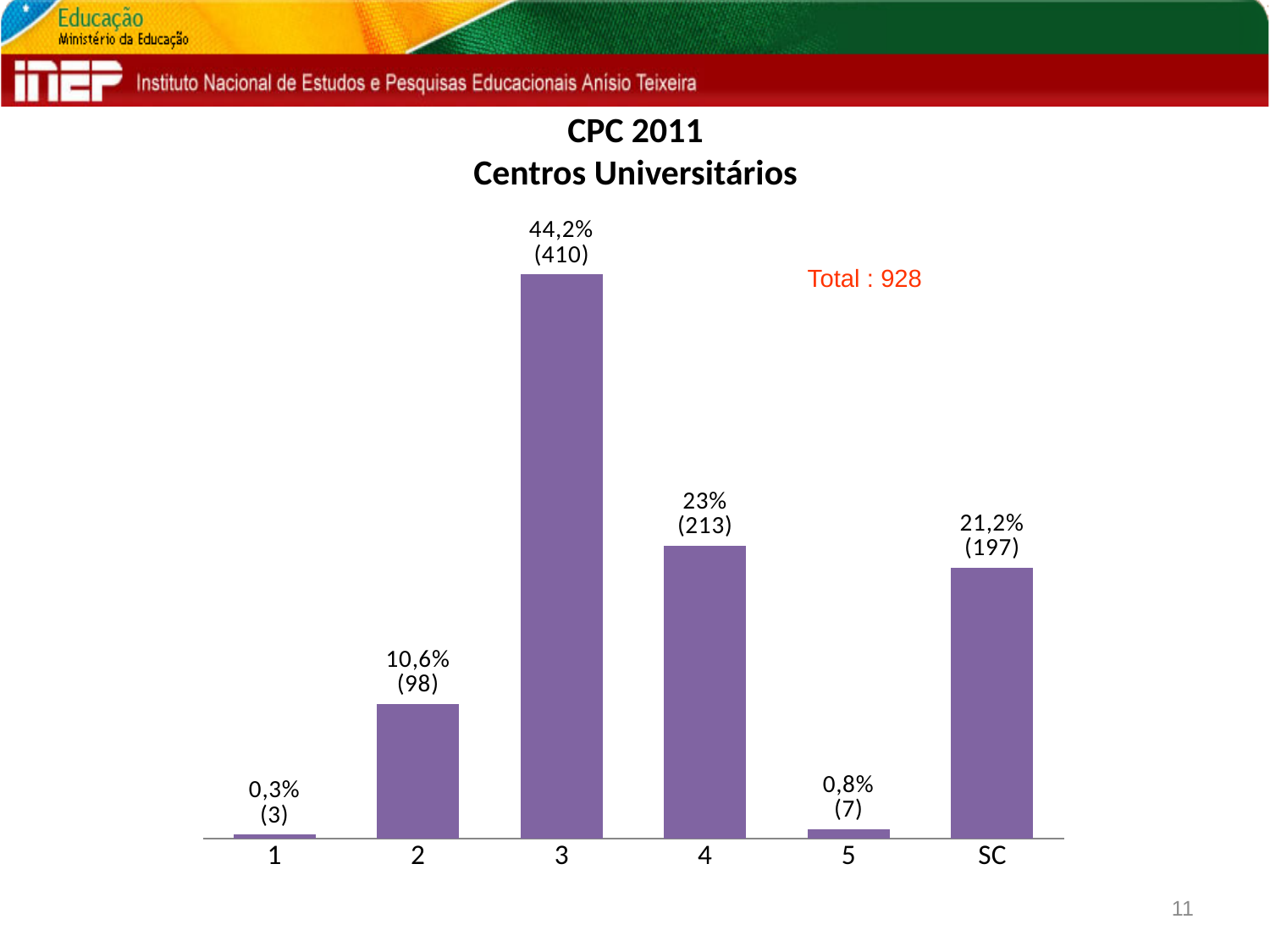
Which category has the highest value? 3 What total is stated on the slide? 928 What count is shown in parentheses for category 4? 213 What percentage is shown for category 3? 44,2% Which category has the lowest value? 1 Which has a larger value, category 4 or SC? 4 What is the difference in counts between category 3 and category 4? 197 What is the title of the chart? CPC 2011 Centros Universitários What percentage is shown for the SC category? 21,2% How many categories are shown on the x axis? 6 What kind of chart is shown on the slide? Bar chart What count is shown in parentheses for category 2? 98